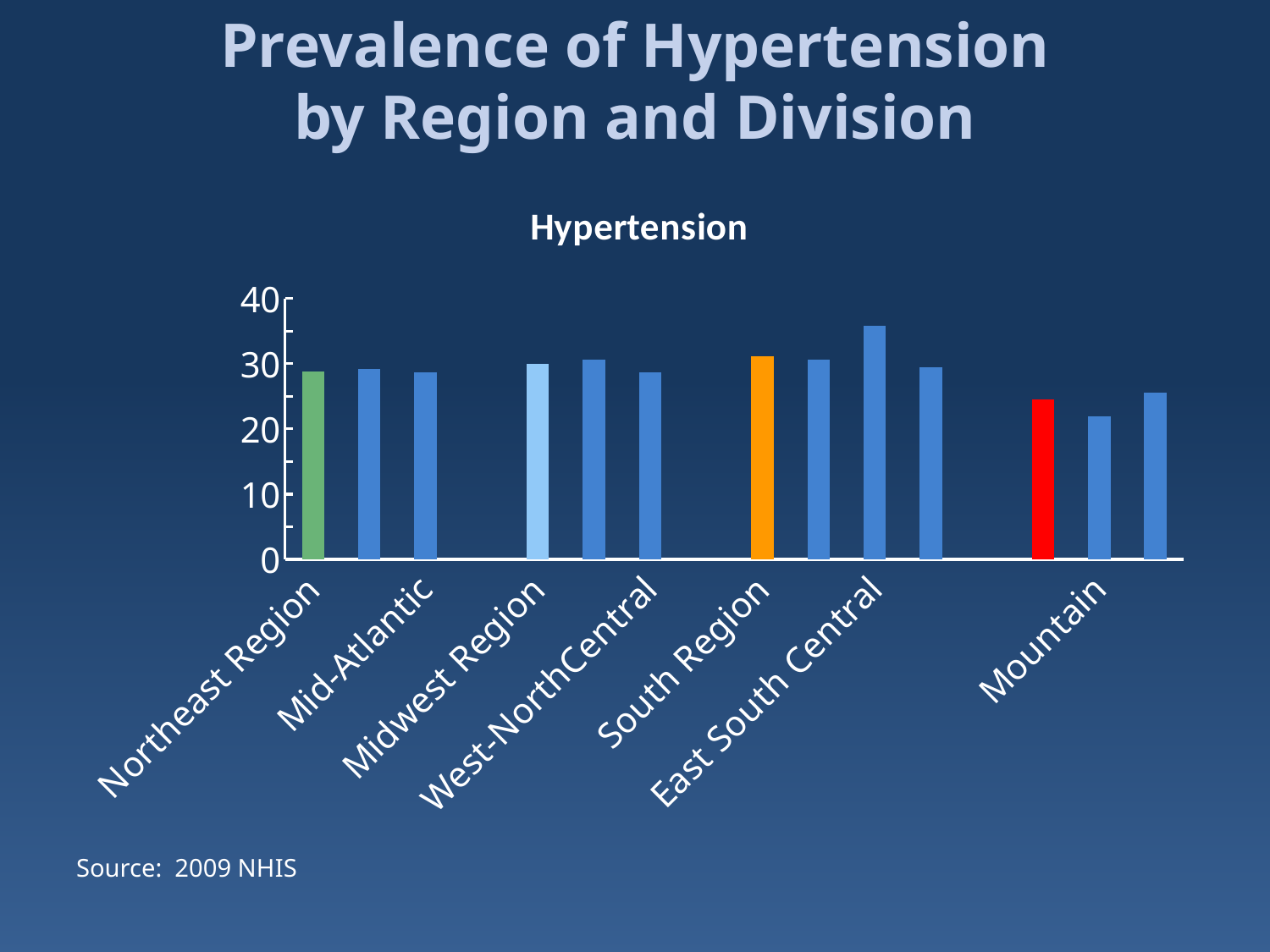
Is the value for West-NorthCentral greater or less than 30? less Which labelled category has the lowest hypertension prevalence? Mountain How many bars are plotted in the chart? 13 What kind of chart is shown on the slide? bar chart What colour is the bar for South Region? orange Is the value for Mountain greater or less than 20? greater Which is larger, the value for East South Central or the value for Mountain? East South Central Is the value for East South Central greater or less than 30? greater Which is larger, the value for Mid-Atlantic or the value for Mountain? Mid-Atlantic Which labelled category has the highest hypertension prevalence? East South Central